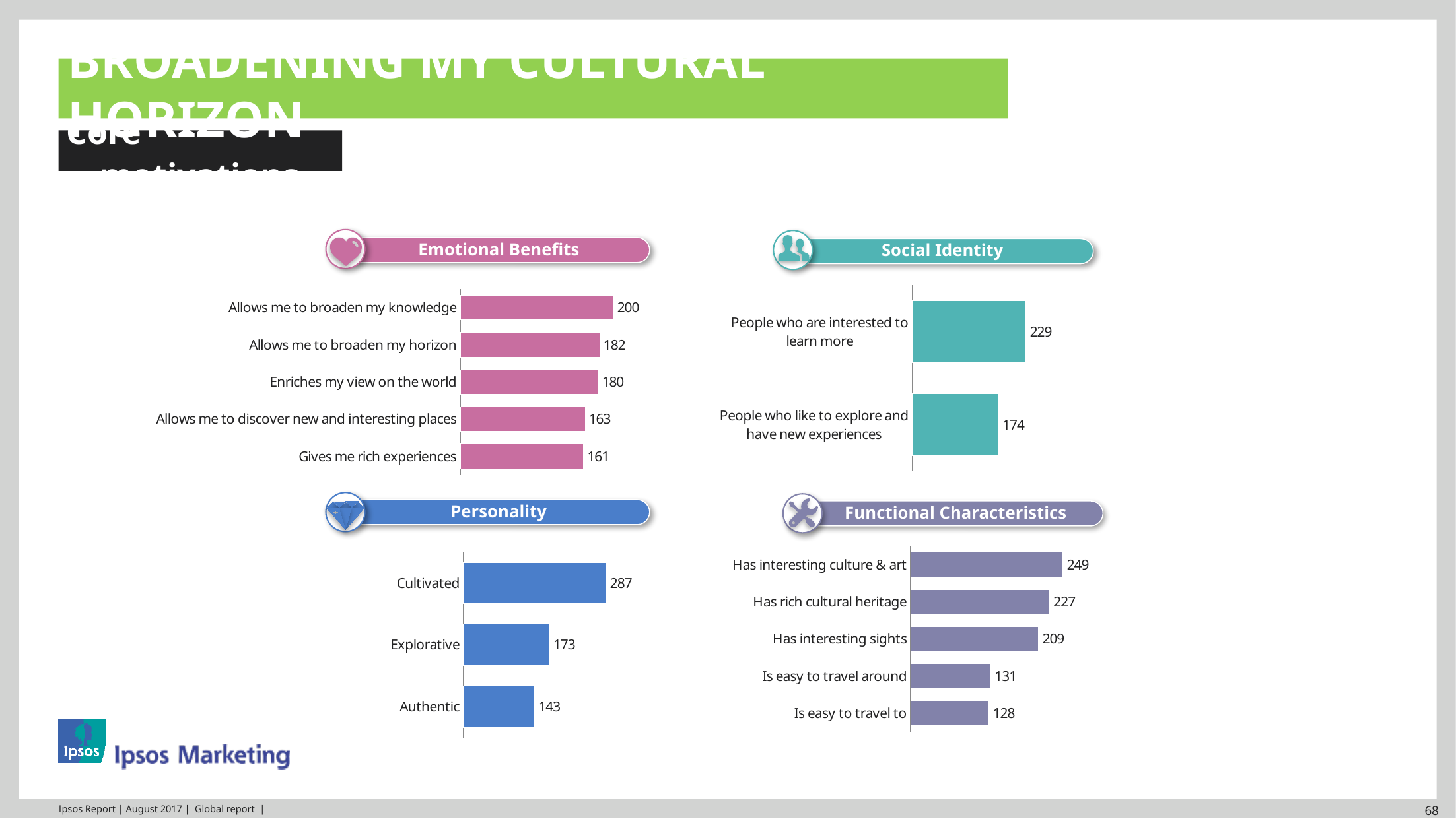
What type of chart is the Personality chart? Bar chart In the Personality chart, what is the difference between Cultivated and Explorative? 114 In the Social Identity chart, what is the value for "People who like to explore and have new experiences"? 174 In the Emotional Benefits chart, which category has the lowest value? Gives me rich experiences In the Functional Characteristics chart, how many categories are shown? 5 In the Functional Characteristics chart, what is the value for "Has interesting sights"? 209 In the Personality chart, which category has the highest value? Cultivated In the Personality chart, what is the value for Authentic? 143 In the Social Identity chart, what is the difference between the two values? 55 In the Emotional Benefits chart, what is the value for "Allows me to broaden my knowledge"? 200 In the Functional Characteristics chart, which is larger: "Is easy to travel around" or "Is easy to travel to"? Is easy to travel around In the Emotional Benefits chart, how many categories are shown? 5